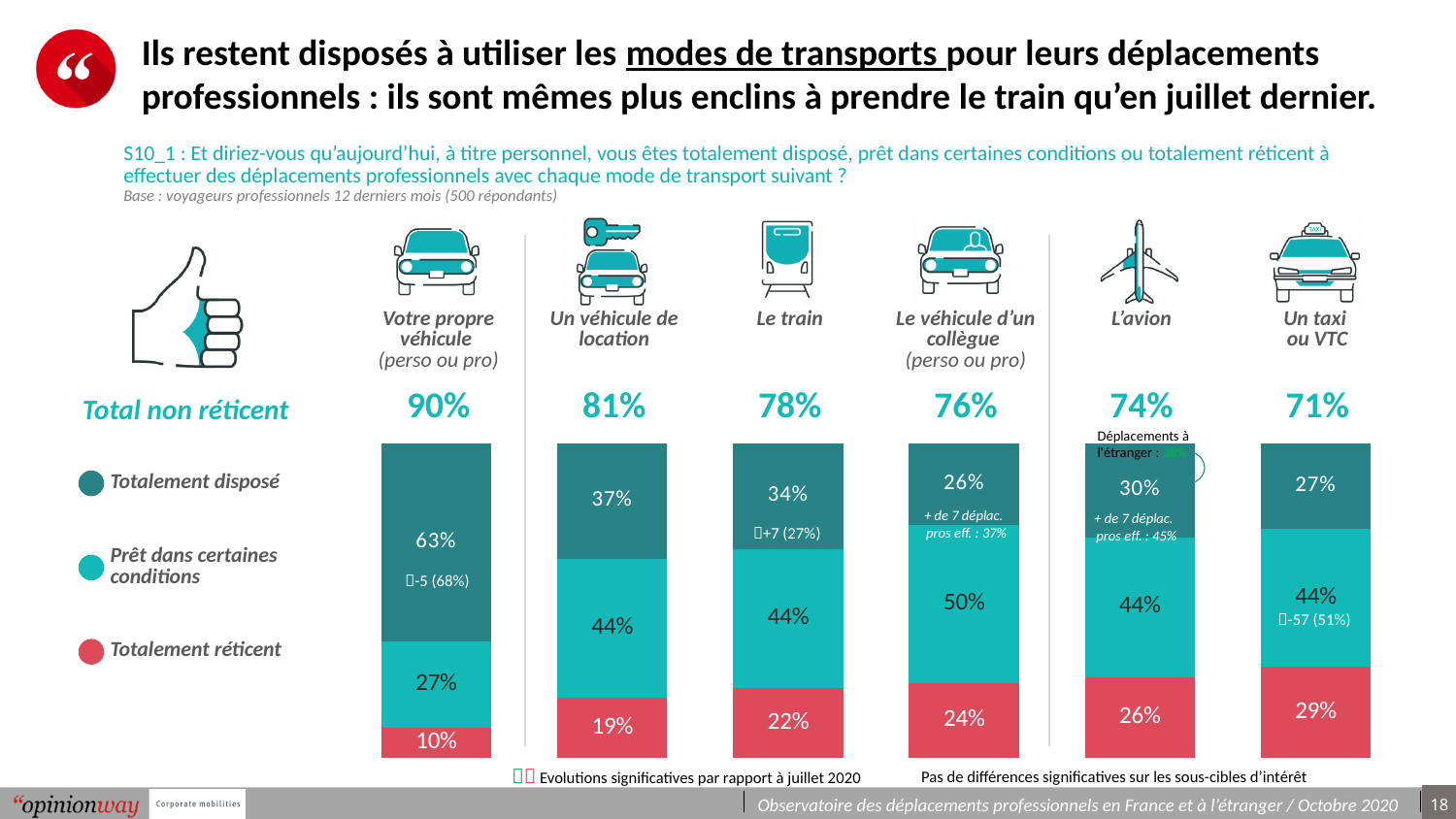
Which transport mode has the lowest 'Totalement disposé' share? Le véhicule d'un collègue What kind of chart is shown on the slide? Stacked bar chart Which is larger: the 'Totalement disposé' share for 'Un véhicule de location' or for 'Le train'? Un véhicule de location Which transport mode has the highest 'Total non réticent' value? Votre propre véhicule How many transport modes are shown in the chart? 6 How many series does the legend list? 3 What percentage of respondents are 'Prêt dans certaines conditions' for 'Le véhicule d'un collègue'? 50% What is the difference between the 'Total non réticent' values for 'Votre propre véhicule' and 'Un taxi ou VTC'? 19 percentage points Which transport mode has the highest 'Totalement réticent' share? Un taxi ou VTC What is the 'Total non réticent' value for 'Le train'? 78% What percentage of respondents are 'Totalement disposé' to use 'Votre propre véhicule'? 63% What percentage of respondents are 'Totalement réticent' to use 'L'avion'? 26%